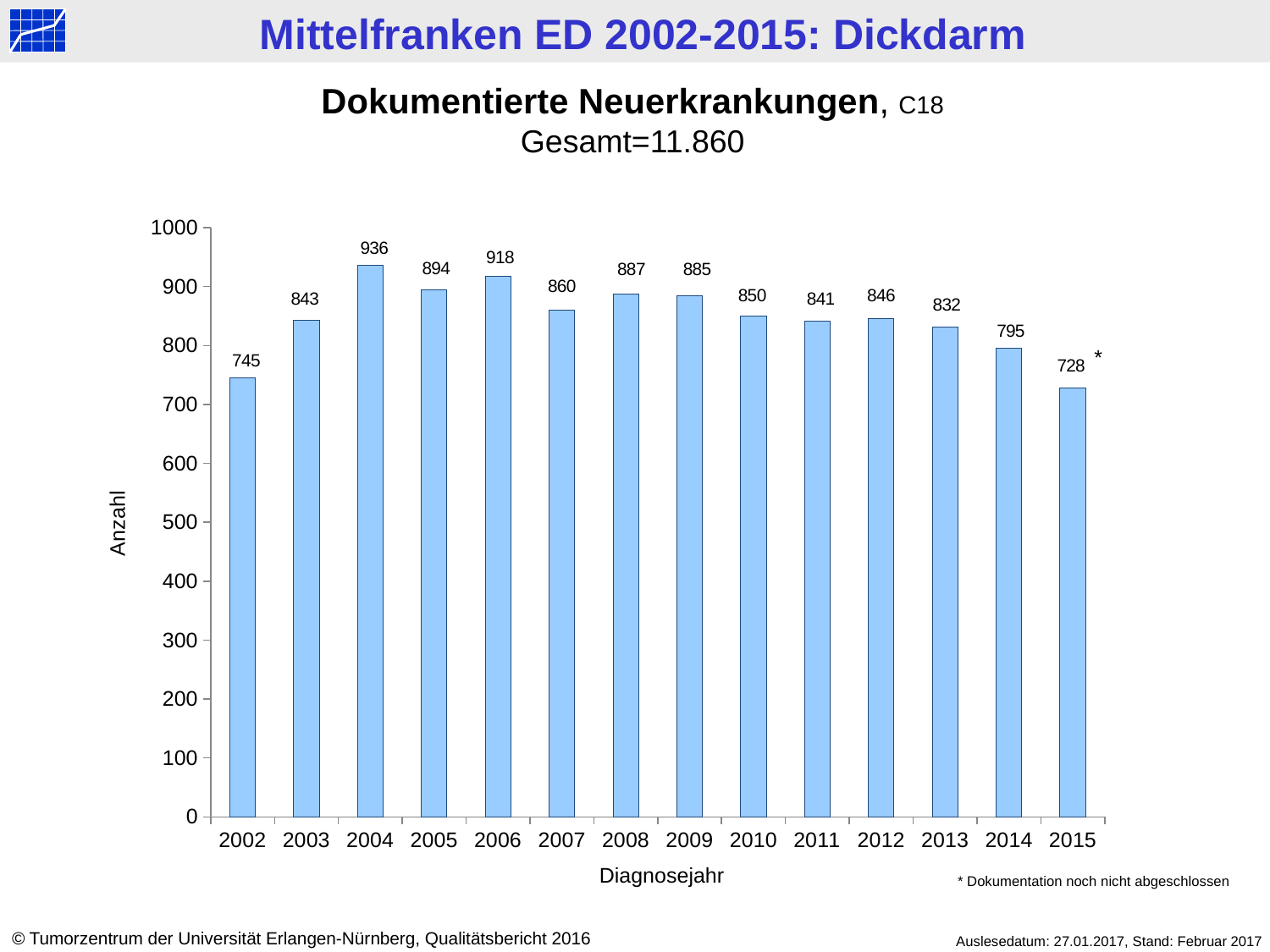
How many years are shown on the x axis? 14 What is the difference between the values for 2004 and 2002? 191 What kind of chart is shown? bar chart What is the label of the y axis? Anzahl What is the value for 2015? 728 Which is larger, the value for 2006 or the value for 2008? 2006 What is the value for 2009? 885 What is the value for 2004? 936 Which year has the lowest value? 2015 Which year has the highest value? 2004 Do the values rise or fall from 2012 to 2015? fall Is the value for 2014 greater or less than 800? less